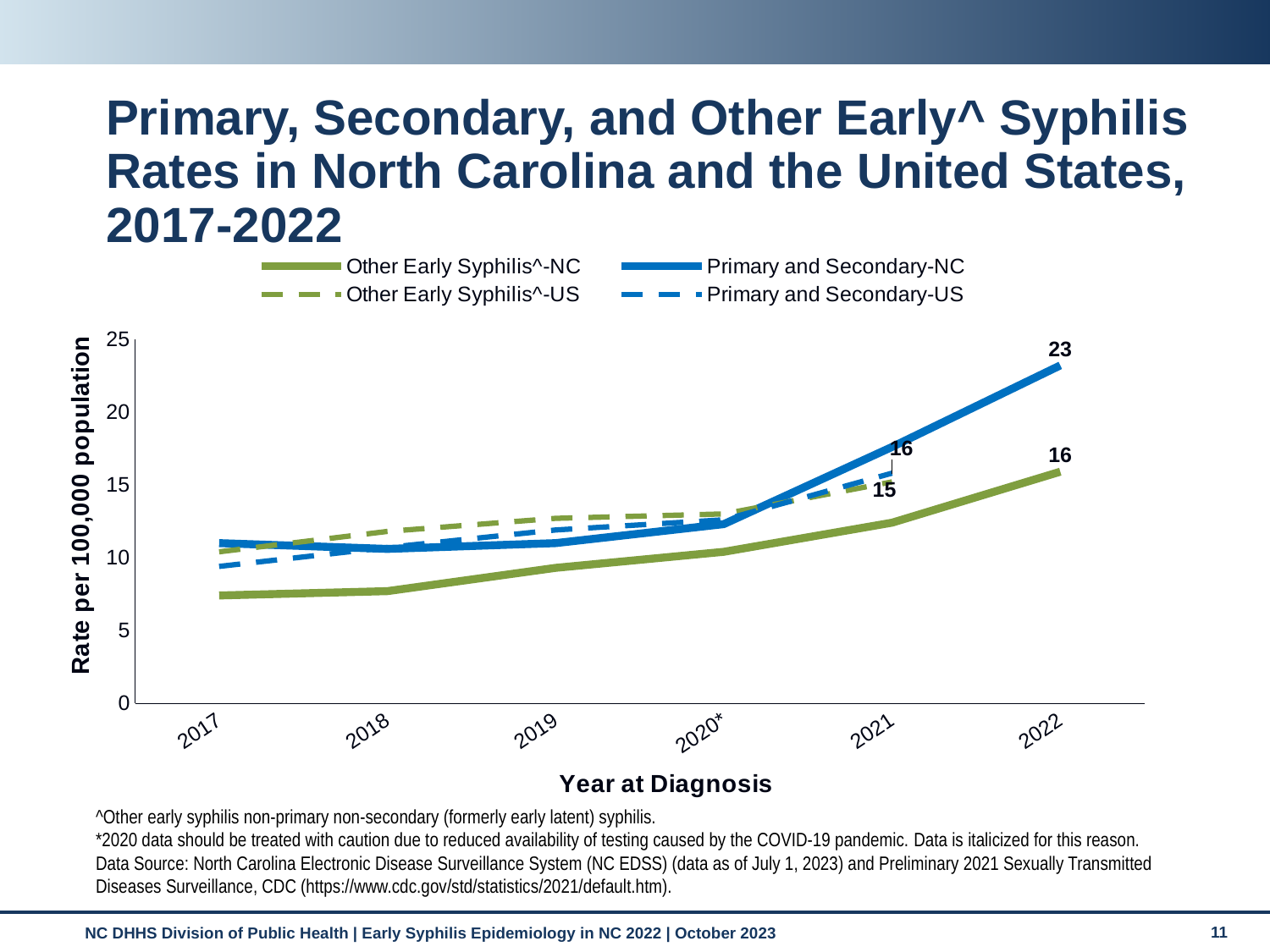
What kind of chart is shown on the slide? line chart Is the Primary and Secondary-NC rate in 2017 greater or less than 15? less Which series has the lowest rate in 2017? Other Early Syphilis^-NC What is the Primary and Secondary-US rate in 2021? 16 What is the Primary and Secondary-NC rate in 2022? 23 How many years are shown on the x axis? 6 What is the difference between the Primary and Secondary-NC rate and the Other Early Syphilis^-NC rate in 2022? 7 In 2022, which is higher: Primary and Secondary-NC or Other Early Syphilis^-NC? Primary and Secondary-NC Does the Other Early Syphilis^-NC rate rise or fall from 2017 to 2022? rise What is the Other Early Syphilis^-NC rate in 2022? 16 How many series does the legend list? 4 Is the Other Early Syphilis^-NC rate in 2017 greater or less than 10? less